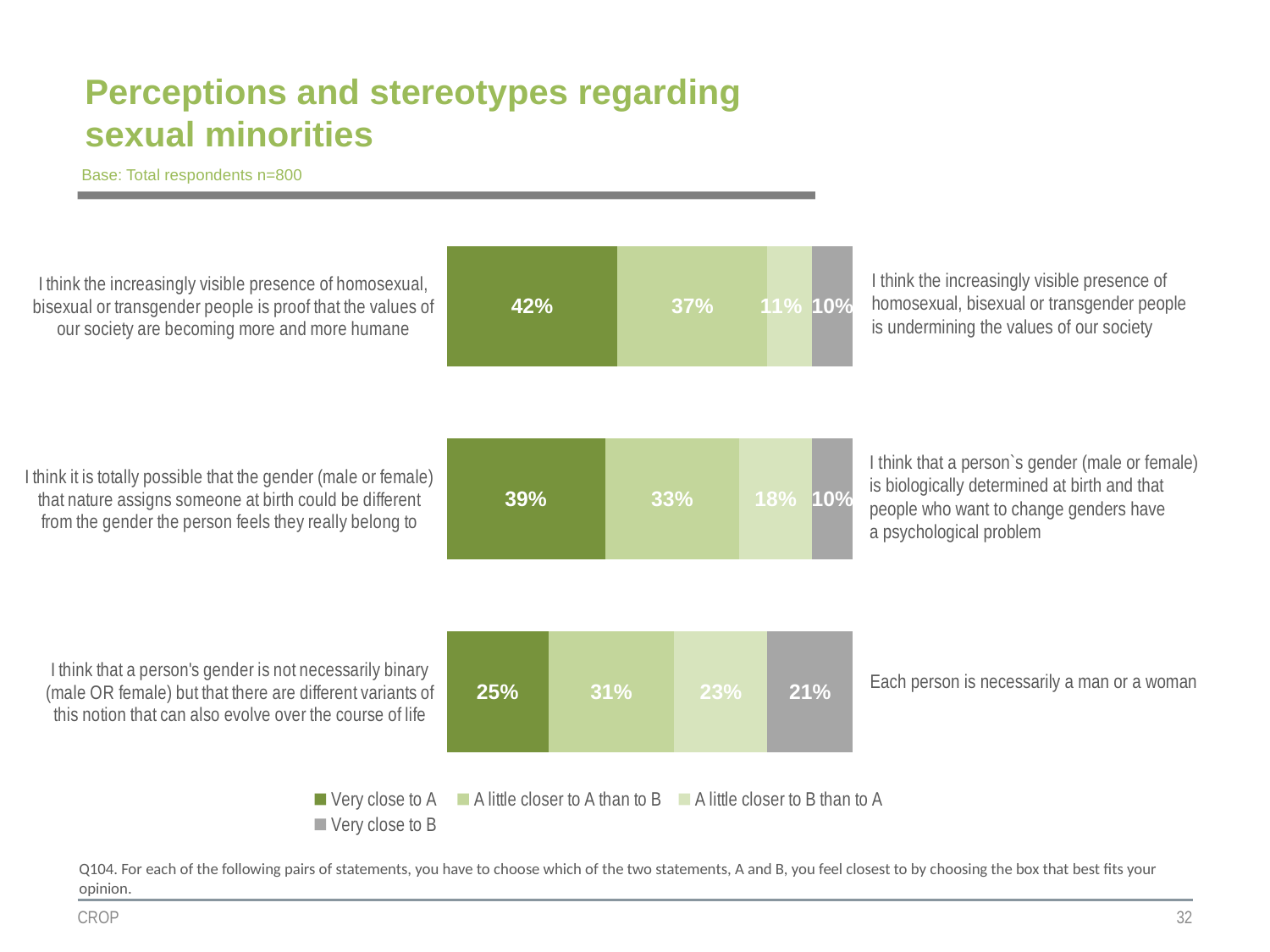
Is the 'Very close to B' value larger for the bottom bar (gender is not necessarily binary) or the middle bar (gender assigned at birth could be different)? The bottom bar What percentage of respondents are 'Very close to A' for the top bar (visible presence of homosexual, bisexual or transgender people is proof that society is becoming more humane)? 42% What is the difference between the 'Very close to A' values of the top bar and the bottom bar? 17 percentage points How many statement pairs (bars) are plotted on the chart? 3 What kind of chart is shown on the slide? Stacked bar chart What percentage of respondents are 'A little closer to B than to A' for the middle bar (gender assigned at birth could be different from the gender the person feels they belong to)? 18% What is the base (number of respondents) stated on the slide? n=800 What percentage of respondents are 'Very close to B' for the bottom bar (gender is not necessarily binary)? 21% What is the total of the four segments in the bottom bar (gender is not necessarily binary)? 100% Which bar has the lowest 'Very close to A' value? The bottom bar (gender is not necessarily binary) How many series does the legend list? 4 Which bar has the highest 'Very close to A' value? The top bar (visible presence of homosexual, bisexual or transgender people is proof that society is becoming more humane)